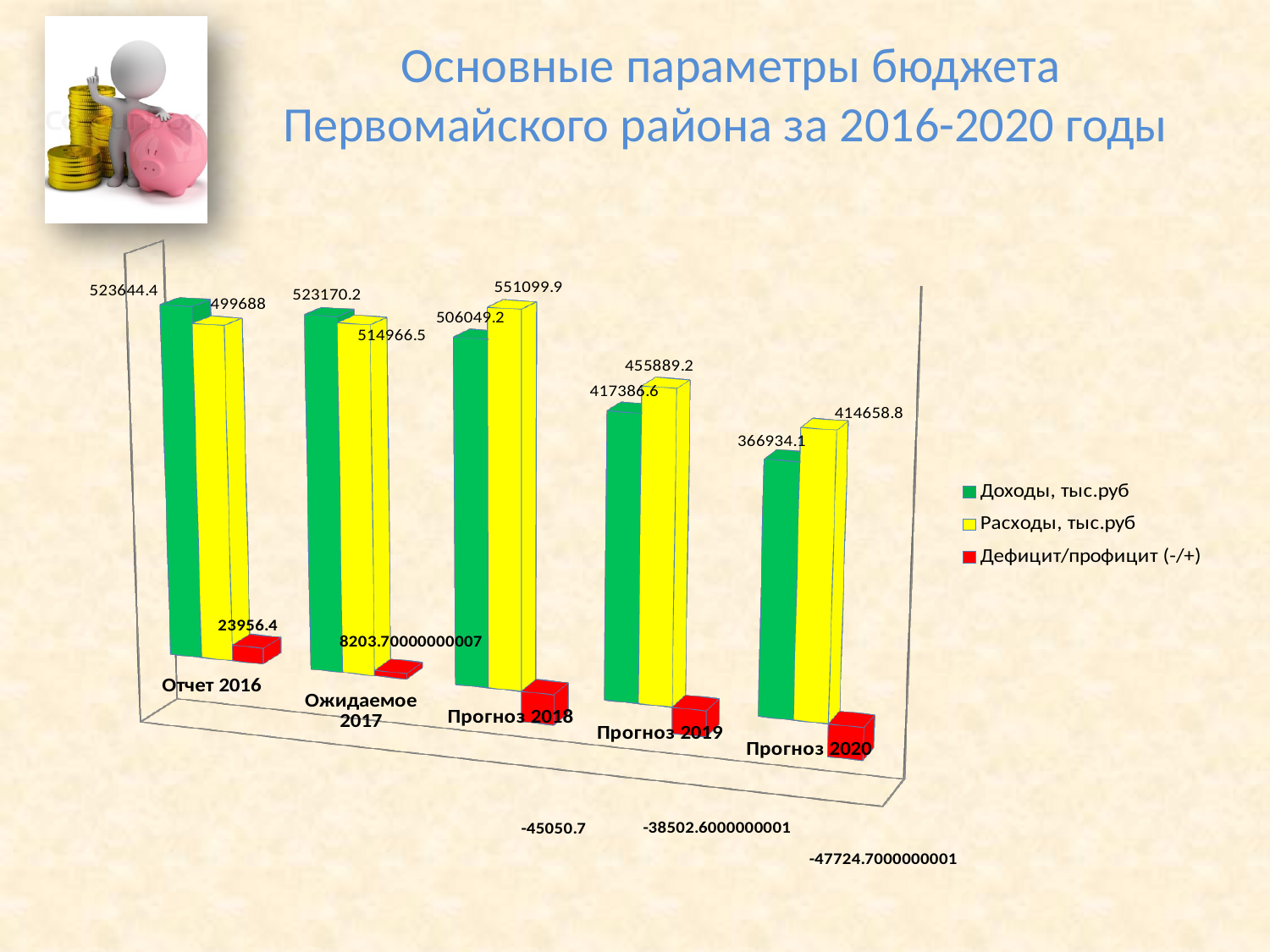
What kind of chart is shown on the slide? Bar chart Which is larger for Прогноз 2019: Доходы, тыс.руб or Расходы, тыс.руб? Расходы, тыс.руб What is the difference between Расходы, тыс.руб and Доходы, тыс.руб for Прогноз 2018? 45050.7 What is the value of Доходы, тыс.руб for Отчет 2016? 523644.4 Which category has the highest value of Расходы, тыс.руб? Прогноз 2018 Which category has the lowest value of Доходы, тыс.руб? Прогноз 2020 What is the value of Расходы, тыс.руб for Прогноз 2018? 551099.9 Do the values of Доходы, тыс.руб rise or fall from Отчет 2016 to Прогноз 2020? Fall How many series does the legend list? 3 What is the value of Дефицит/профицит (-/+) for Отчет 2016? 23956.4 What is the value of Расходы, тыс.руб for Прогноз 2020? 414658.8 How many categories are shown on the x axis of the chart? 5